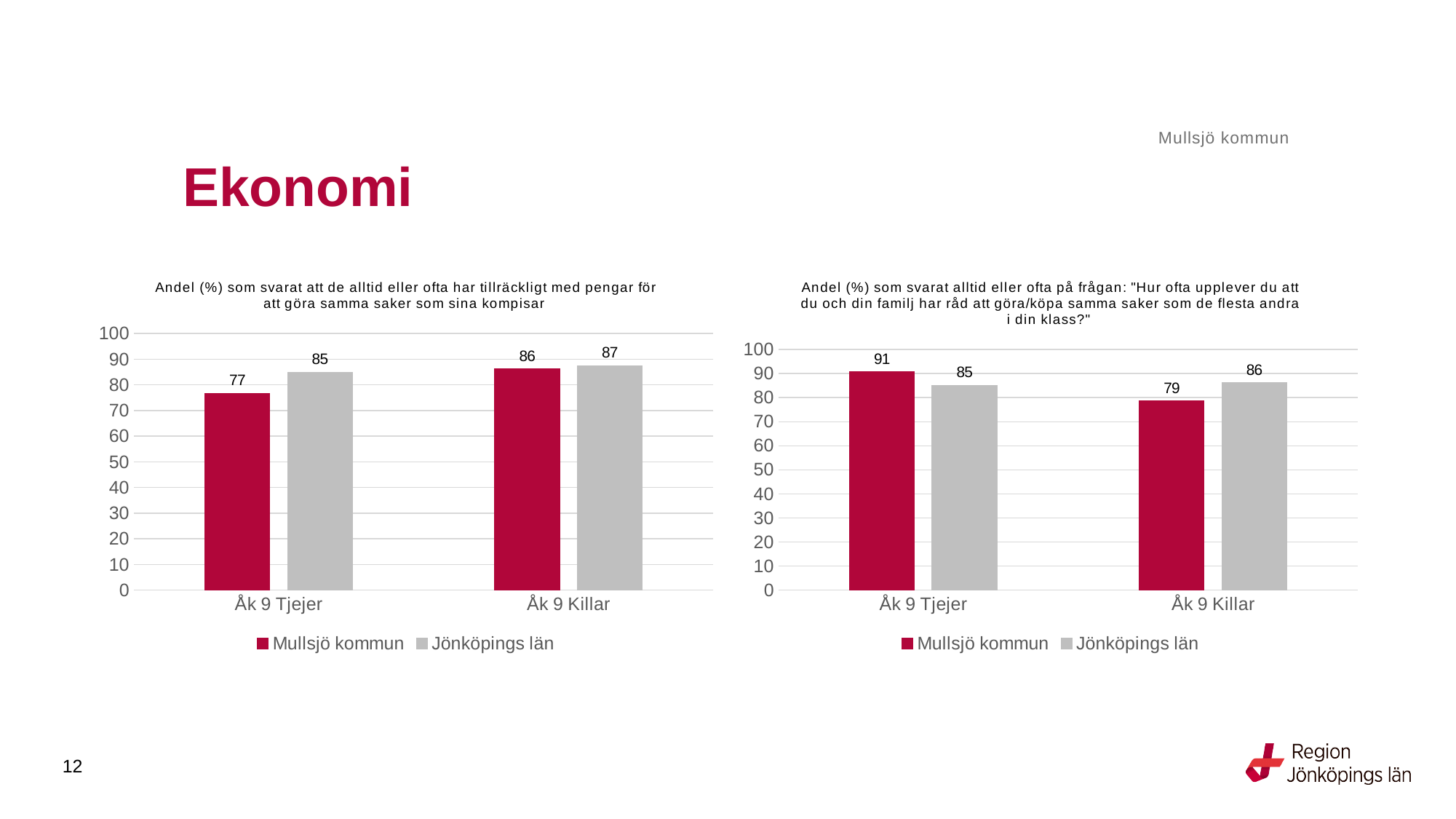
In the right chart, which is larger for Åk 9 Killar: Mullsjö kommun or Jönköpings län? Jönköpings län In the right chart, what is the difference between Mullsjö kommun and Jönköpings län for Åk 9 Tjejer? 6 How many series does the legend of the left chart list? 2 In the right chart, what is the value for Mullsjö kommun for Åk 9 Tjejer? 91 In the left chart, which category has the lowest Mullsjö kommun value? Åk 9 Tjejer In the right chart, which category has the highest Mullsjö kommun value? Åk 9 Tjejer In the left chart, what is the difference between Jönköpings län and Mullsjö kommun for Åk 9 Tjejer? 8 In the left chart, what is the value for Mullsjö kommun for Åk 9 Tjejer? 77 In the right chart, what is the value for Jönköpings län for Åk 9 Killar? 86 What kind of chart is the right chart? Bar chart How many categories are shown on the x axis of the right chart? 2 In the left chart, what is the value for Jönköpings län for Åk 9 Killar? 87